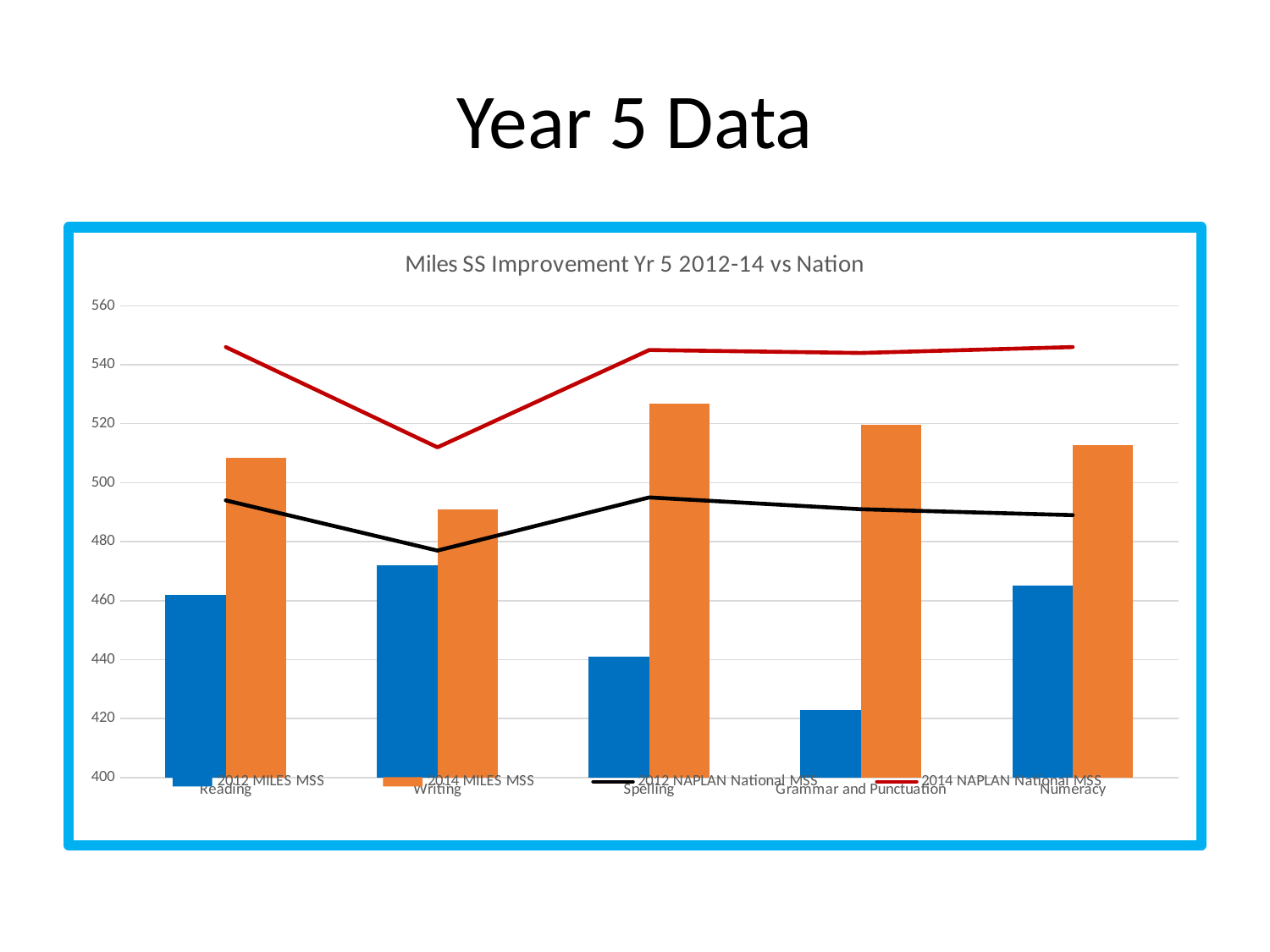
Which category has the lowest value for the 2014 NAPLAN National MSS line? Writing Is the 2014 MILES MSS value for Spelling greater or less than 520? greater What kind of chart is shown on the slide? A combined bar and line chart How many series does the chart's legend list? 4 Which category has the highest value for the 2014 MILES MSS series? Spelling Is the 2014 NAPLAN National MSS value for Writing greater or less than 520? less What is the title of the chart? Miles SS Improvement Yr 5 2012-14 vs Nation How many categories are shown along the x axis of the chart? 5 Which is larger for the 2014 MILES MSS series: Writing or Grammar and Punctuation? Grammar and Punctuation Is the 2012 MILES MSS value for Reading greater or less than 480? less Which category has the lowest value for the 2012 MILES MSS series? Grammar and Punctuation For Reading, which is larger: the 2012 MILES MSS value or the 2014 MILES MSS value? 2014 MILES MSS